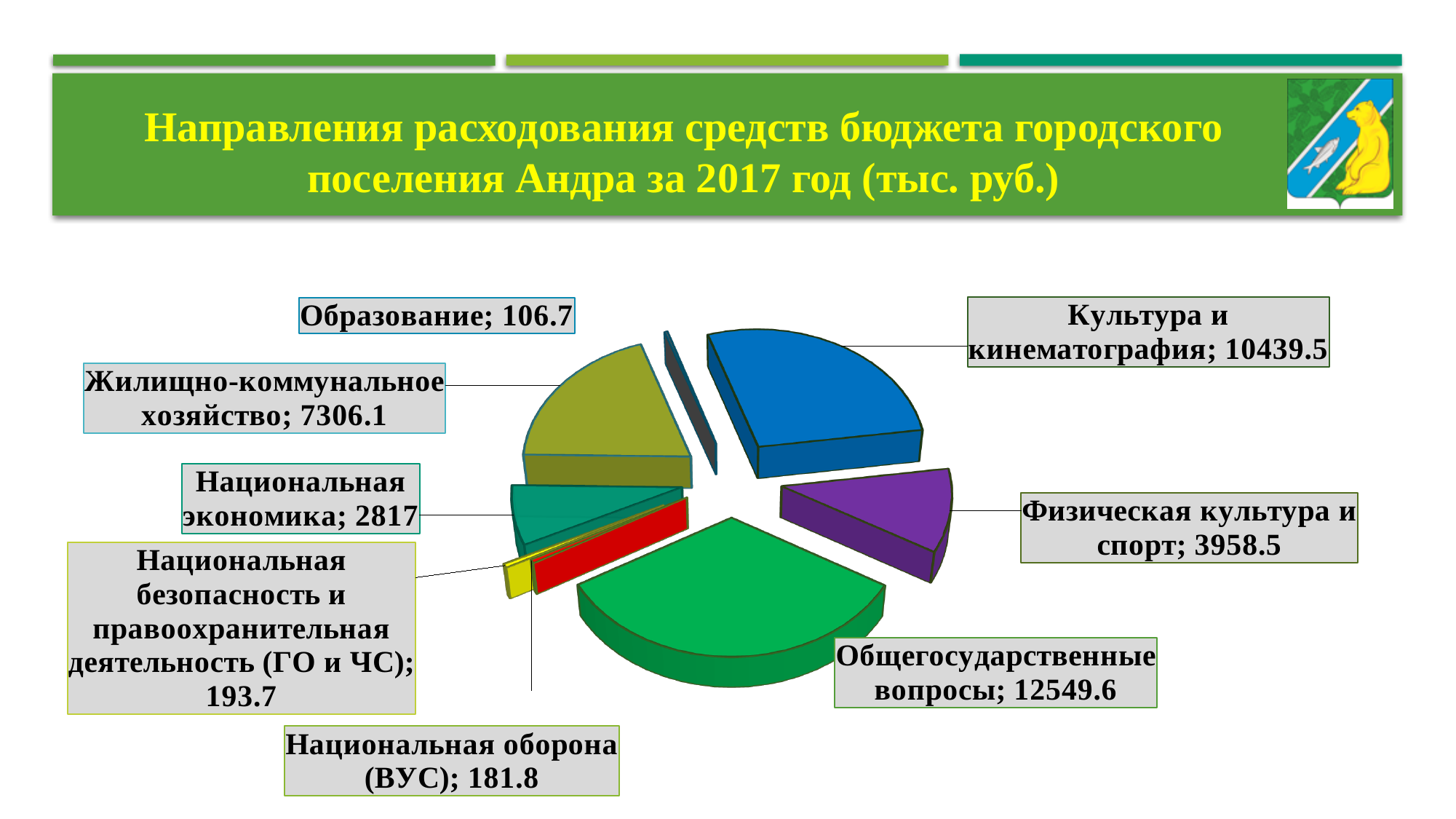
Which category has the highest value? Общегосударственные вопросы What kind of chart is shown on the slide? Pie chart Which is larger: Культура и кинематография or Жилищно-коммунальное хозяйство? Культура и кинематография What is the value for Общегосударственные вопросы? 12549.6 What is the value for Культура и кинематография? 10439.5 How many categories does the pie chart show? 8 What is the title of the chart? Направления расходования средств бюджета городского поселения Андра за 2017 год (тыс. руб.) What is the value for Национальная экономика? 2817 What is the difference between Жилищно-коммунальное хозяйство and Физическая культура и спорт? 3347.6 Which category has the lowest value? Образование What is the value for Национальная оборона (ВУС)? 181.8 What is the difference between Общегосударственные вопросы and Культура и кинематография? 2110.1